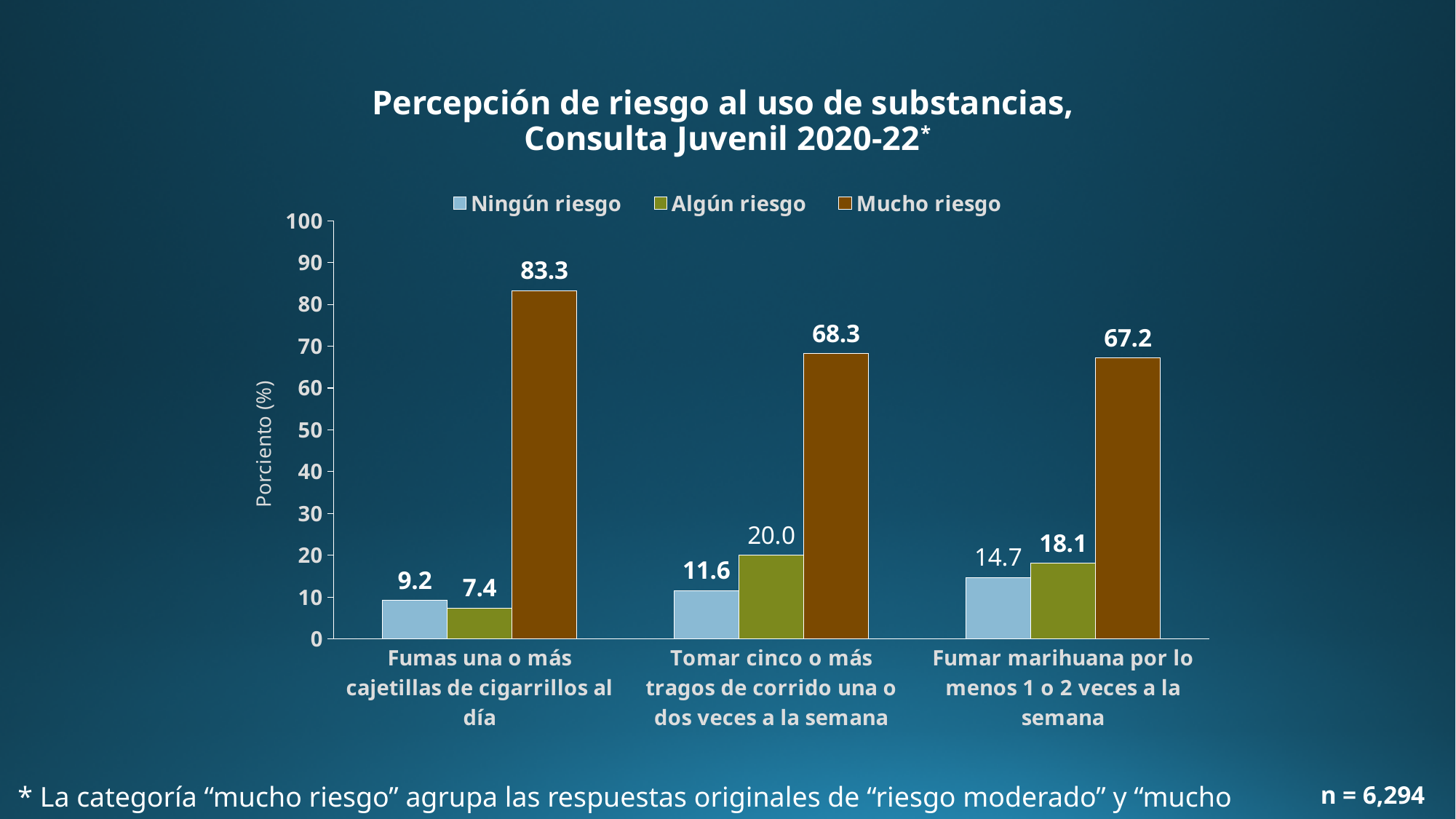
Is the "Mucho riesgo" value for "Fumar marihuana por lo menos 1 o 2 veces a la semana" greater or less than 70? less What is the value for "Mucho riesgo" for "Fumas una o más cajetillas de cigarrillos al día"? 83.3 What is the value for "Algún riesgo" for "Tomar cinco o más tragos de corrido una o dos veces a la semana"? 20.0 What is the value for "Ningún riesgo" for "Fumar marihuana por lo menos 1 o 2 veces a la semana"? 14.7 Which category has the lowest "Algún riesgo" value? Fumas una o más cajetillas de cigarrillos al día Which is larger: the "Ningún riesgo" value for "Tomar cinco o más tragos de corrido una o dos veces a la semana" or for "Fumar marihuana por lo menos 1 o 2 veces a la semana"? Fumar marihuana por lo menos 1 o 2 veces a la semana How many series does the legend list? 3 What is the difference between the "Mucho riesgo" values for "Fumas una o más cajetillas de cigarrillos al día" and "Tomar cinco o más tragos de corrido una o dos veces a la semana"? 15.0 What is the label of the y axis? Porciento (%) What kind of chart is shown on the slide? bar chart How many categories are shown on the x axis? 3 Which category has the highest "Mucho riesgo" value? Fumas una o más cajetillas de cigarrillos al día